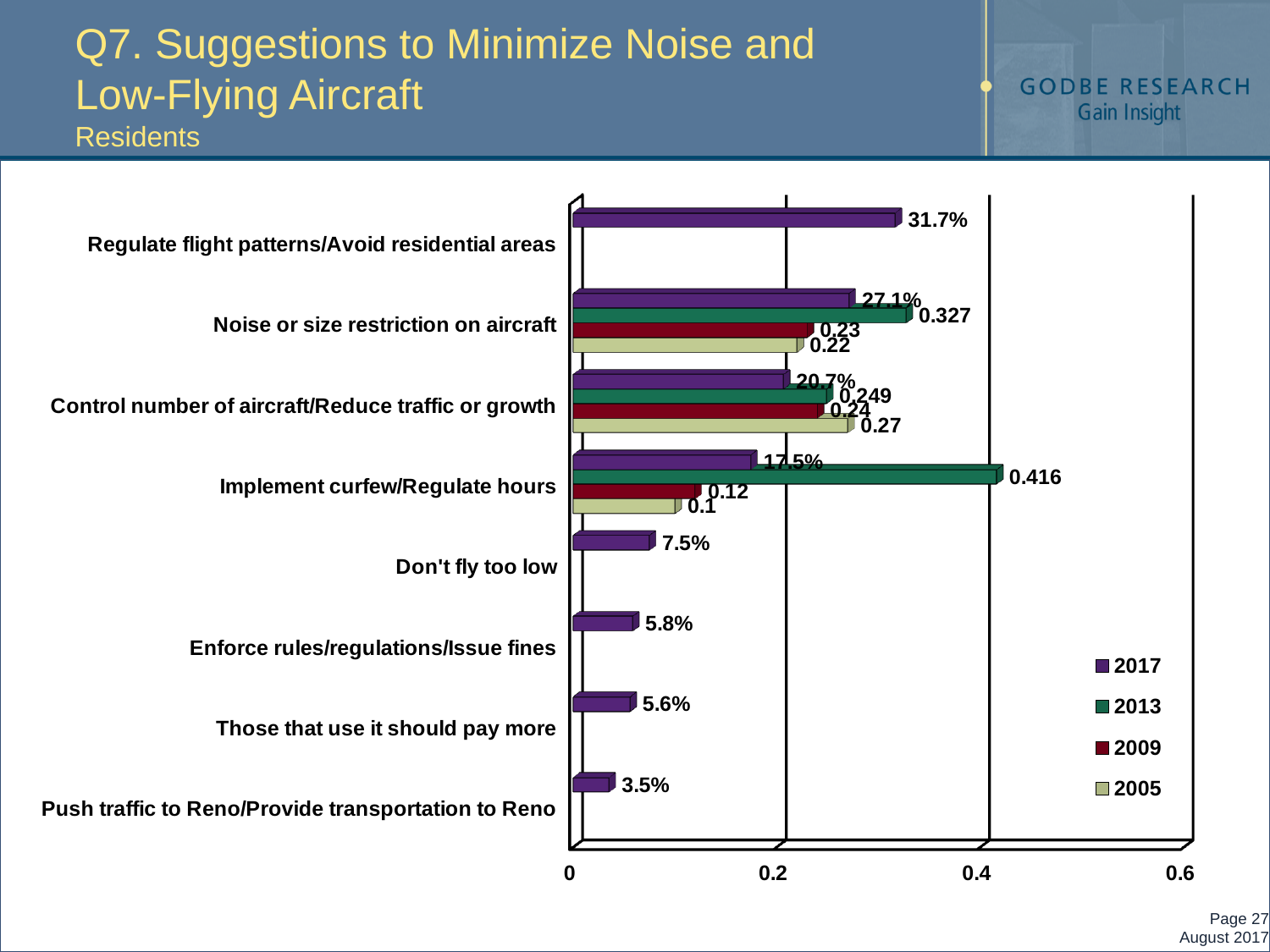
What is the 2013 value for "Implement curfew/Regulate hours"? 0.416 Which category has the lowest 2017 value? Push traffic to Reno/Provide transportation to Reno What kind of chart is shown on the slide? Bar chart Is the 2013 value for "Implement curfew/Regulate hours" greater or less than 0.4? greater What is the difference between the 2009 and 2005 values for "Implement curfew/Regulate hours"? 0.02 How many categories are shown on the chart? 8 What is the 2005 value for "Control number of aircraft/Reduce traffic or growth"? 0.27 What is the 2017 value for "Push traffic to Reno/Provide transportation to Reno"? 3.5% For the 2013 series, which is larger: "Implement curfew/Regulate hours" or "Noise or size restriction on aircraft"? Implement curfew/Regulate hours What is the 2017 value for "Regulate flight patterns/Avoid residential areas"? 31.7% How many series does the legend list? 4 Which category has the highest 2017 value? Regulate flight patterns/Avoid residential areas